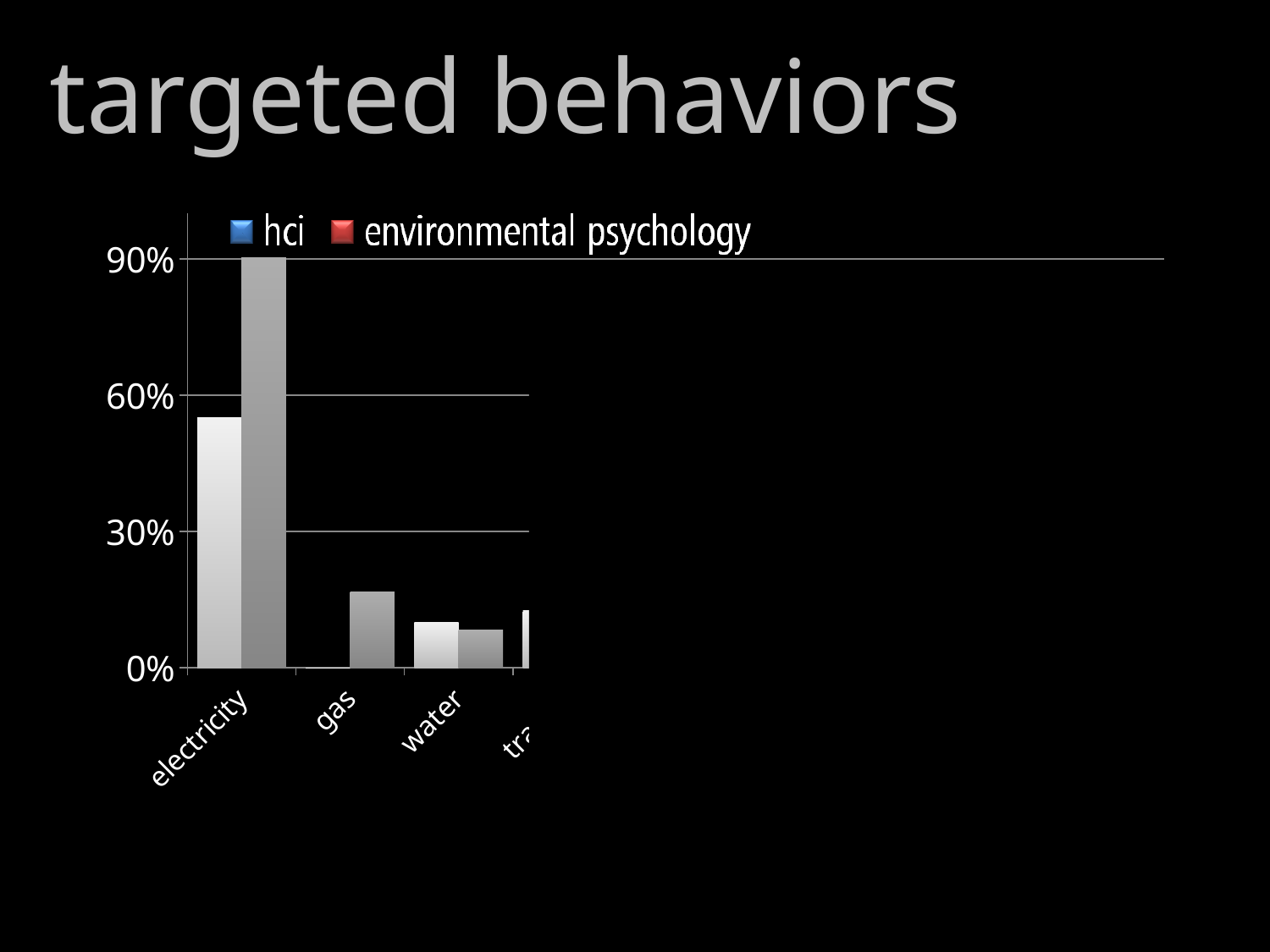
Is the taller bar for electricity greater or less than 60%? greater Is the taller bar for water greater or less than 30%? less Which category has a larger tallest bar, electricity or gas? electricity Is the taller bar for gas greater or less than 30%? less Which category has a larger tallest bar, gas or water? gas How many series does the chart legend list? 2 What are the two series named in the chart legend? hci and environmental psychology Which category has the tallest bar in the chart? electricity Do the bar heights generally rise or fall moving from electricity to water along the x axis? fall What is the title of the slide containing the chart? targeted behaviors What kind of chart is shown on the slide? bar chart